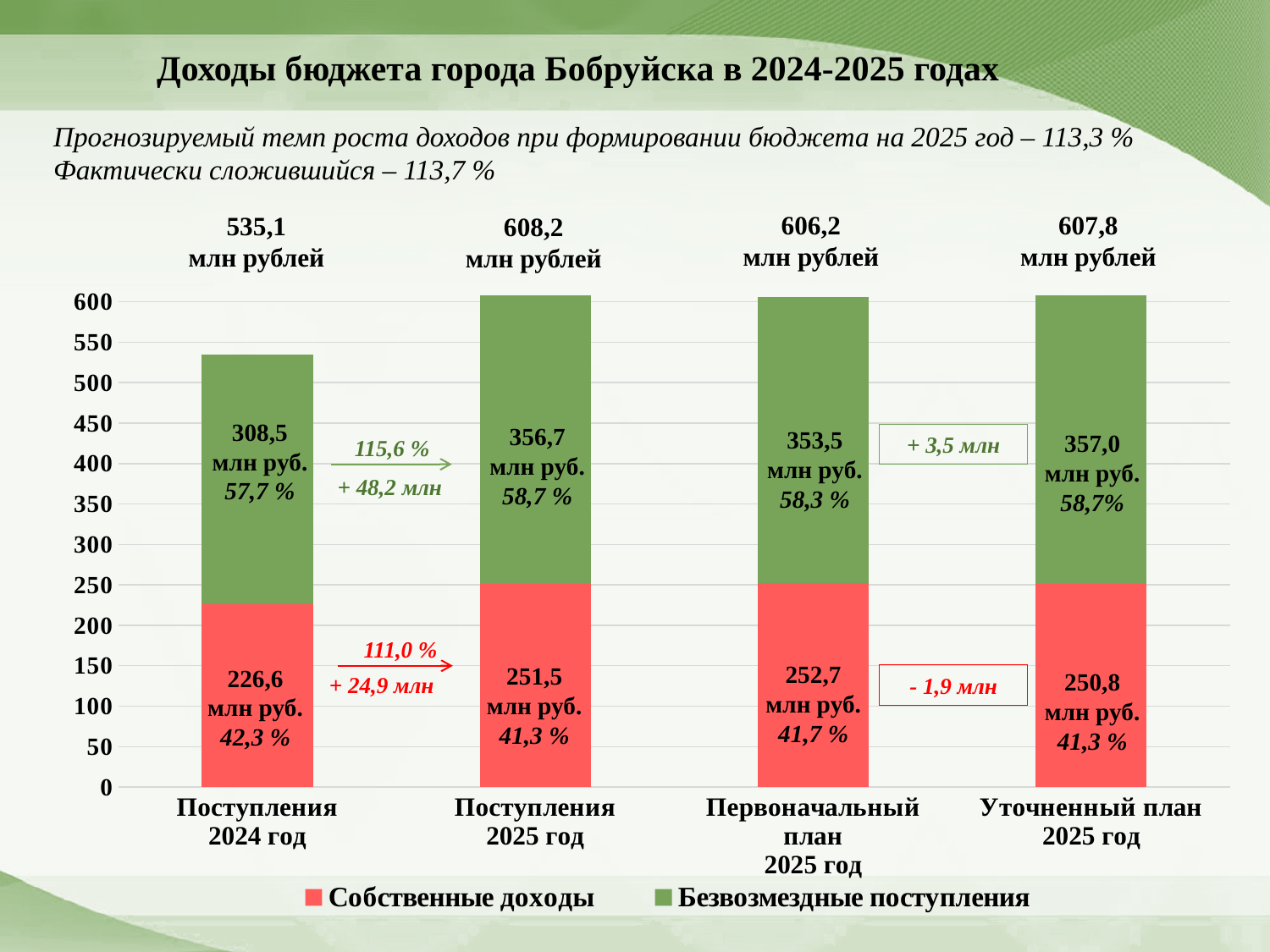
Which colour represents Безвозмездные поступления in the chart? Green What is the difference in Безвозмездные поступления between Поступления 2025 год and Поступления 2024 год? 48,2 млн What share of the Уточненный план 2025 год bar is Собственные доходы? 41,3 % What type of chart is shown on the slide? Stacked bar chart What is the total of the stacked bar for Первоначальный план 2025 год? 606,2 млн рублей How many series does the legend list? 2 How many categories are shown on the x axis? 4 What is the value of Безвозмездные поступления for Поступления 2025 год? 356,7 млн руб. What is the value of Собственные доходы for Поступления 2024 год? 226,6 млн руб. Which category has the highest total? Поступления 2025 год Which is larger: Собственные доходы for Первоначальный план 2025 год or for Уточненный план 2025 год? Первоначальный план 2025 год Which category has the lowest total? Поступления 2024 год